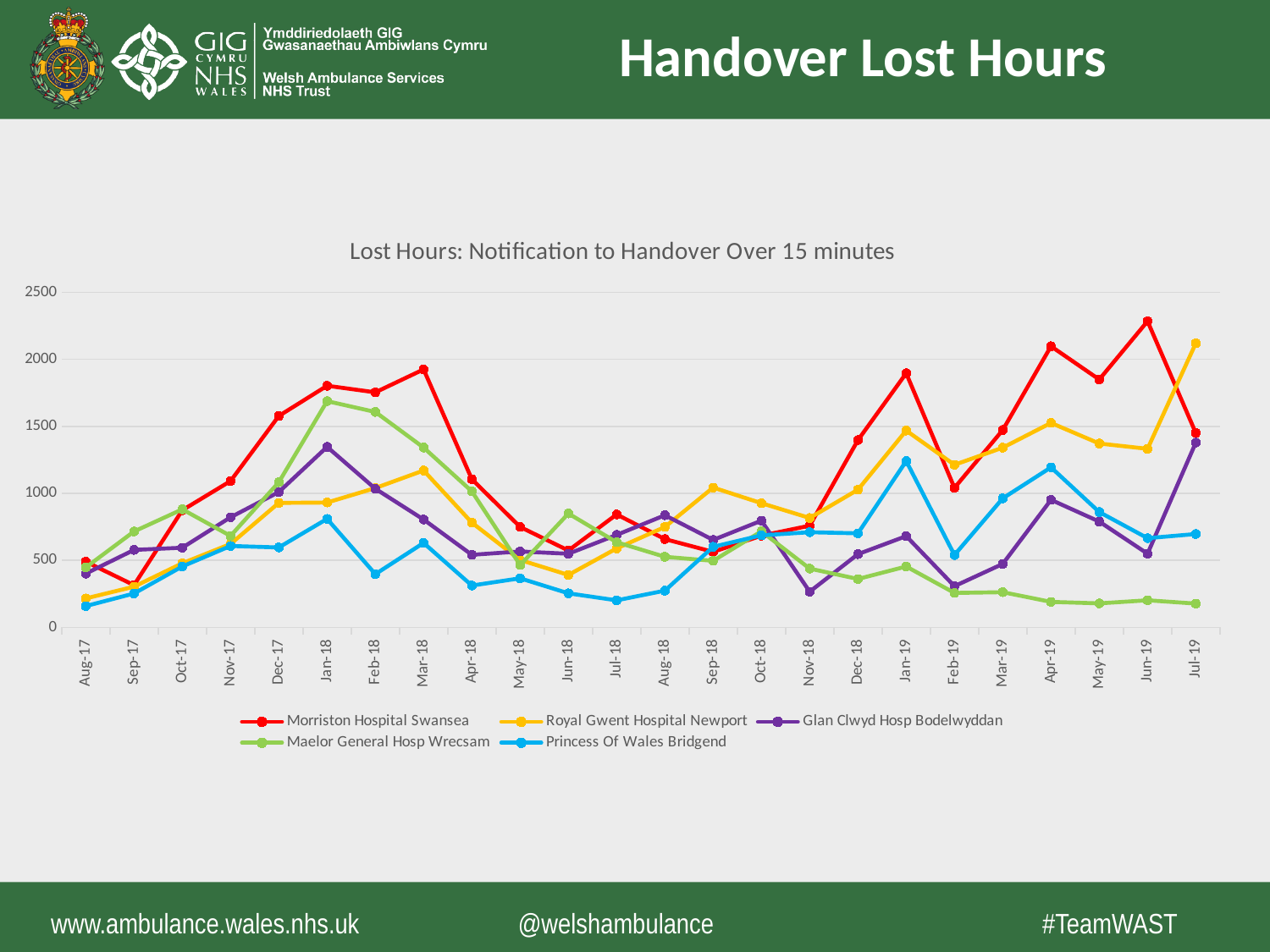
In Apr-19, which is larger: the value for Morriston Hospital Swansea or for Maelor General Hosp Wrecsam? Morriston Hospital Swansea Which hospital has the lowest value in Jul-19? Maelor General Hosp Wrecsam Which hospital has the highest value in Jul-19? Royal Gwent Hospital Newport What is the title of the chart? Lost Hours: Notification to Handover Over 15 minutes Does the value for Morriston Hospital Swansea rise or fall from Aug-17 to Jan-18? rise Is the value for Morriston Hospital Swansea in Mar-18 greater or less than 1500? greater Is the value for Maelor General Hosp Wrecsam in Jul-19 greater or less than 500? less What kind of chart is shown on the slide? line chart Is the value for Morriston Hospital Swansea in Jun-19 greater or less than 2000? greater How many series does the legend list? 5 How many months are plotted along the x axis? 24